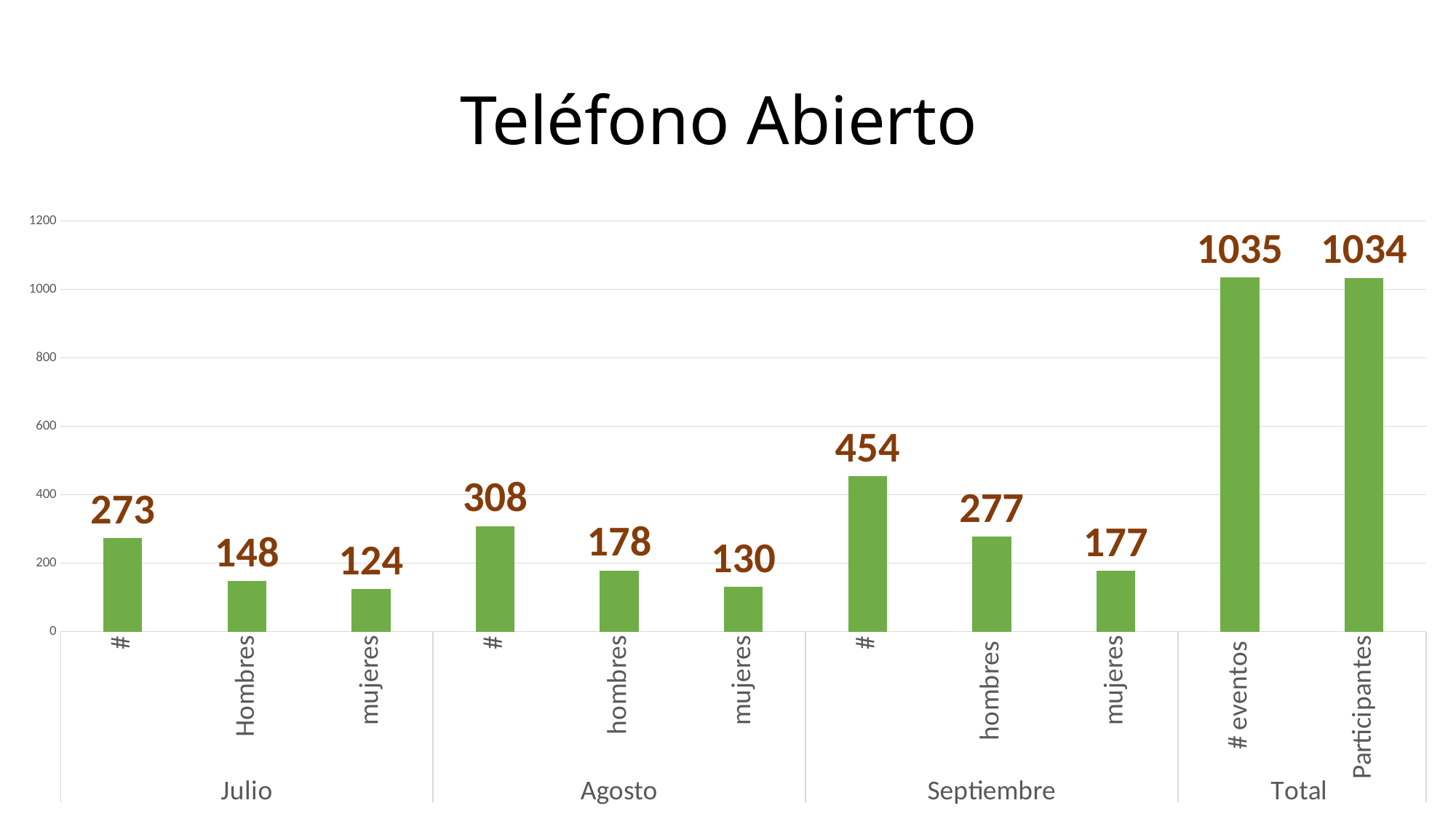
How many bars are plotted in the chart? 11 What is the value for # in Septiembre? 454 What kind of chart is shown? bar chart Which is larger, hombres in Agosto or mujeres in Septiembre? hombres in Agosto What is the value for mujeres in Agosto? 130 What is the title of the chart? Teléfono Abierto What is the difference between # in Agosto and # in Julio? 35 What is the value for Participantes in Total? 1034 What is the difference between hombres and mujeres in Septiembre? 100 Which bar has the highest value? # eventos (Total) What is the value for Hombres in Julio? 148 Which bar has the lowest value? mujeres (Julio)